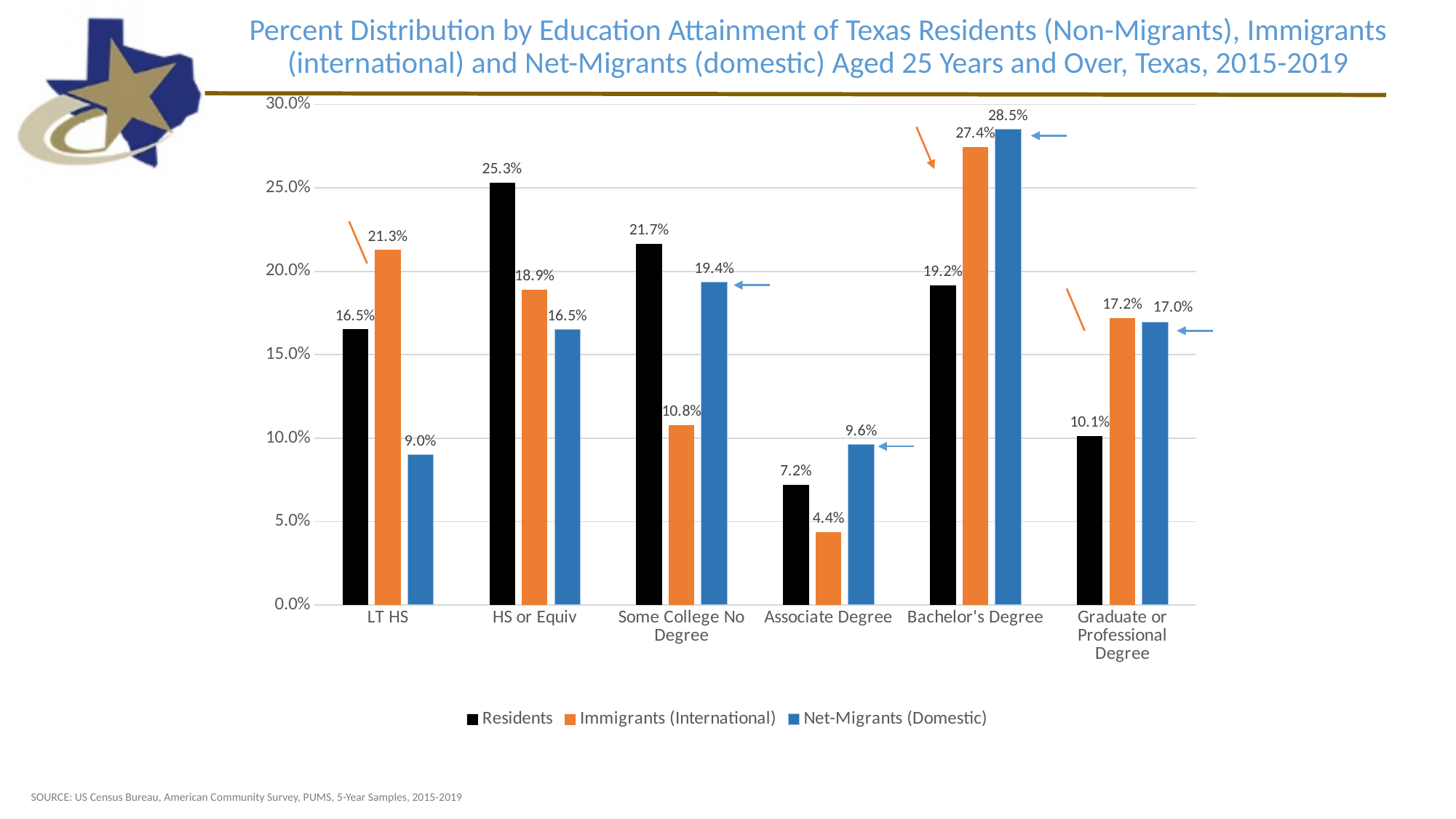
What is the difference between the Immigrants (International) and Residents values in the LT HS category? 4.8% Which education category has the highest value for Immigrants (International)? Bachelor's Degree What is the difference between the Net-Migrants (Domestic) and Immigrants (International) values in the Graduate or Professional Degree category? 0.2% Which colour represents Net-Migrants (Domestic) in the chart? Blue How many series does the legend list? 3 What is the value for Net-Migrants (Domestic) in the Bachelor's Degree category? 28.5% How many education categories are shown on the x axis? 6 What is the value for Immigrants (International) in the Associate Degree category? 4.4% In the Some College No Degree category, which is larger: Residents or Net-Migrants (Domestic)? Residents Which education category has the lowest value for Residents? Associate Degree What is the value for Residents in the HS or Equiv category? 25.3% What kind of chart is shown on the slide? Bar chart